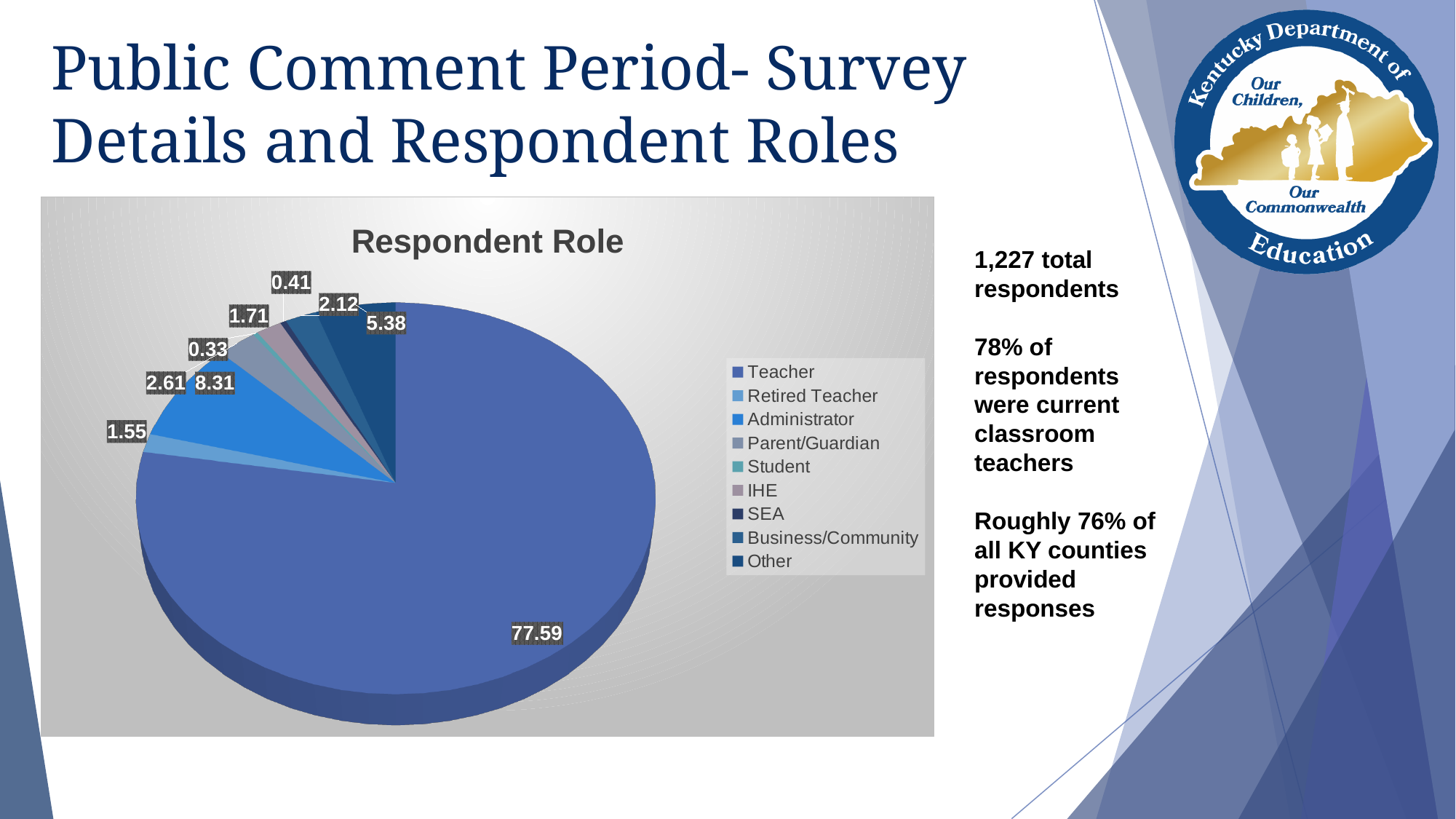
What is the difference between the Teacher value and the Administrator value in the Respondent Role chart? 69.28 What type of chart is shown on the slide? pie chart Which category has the smallest slice in the Respondent Role chart? Student What is the value shown for Teacher in the Respondent Role chart? 77.59 Which category is listed first in the legend of the Respondent Role chart? Teacher What is the title of the chart? Respondent Role How many categories does the legend of the Respondent Role chart list? 9 What is the value shown for Other in the Respondent Role chart? 5.38 Which is larger in the Respondent Role chart, Administrator or Other? Administrator What is the value shown for Administrator in the Respondent Role chart? 8.31 Which category has the largest slice in the Respondent Role chart? Teacher What is the value shown for Parent/Guardian in the Respondent Role chart? 2.61